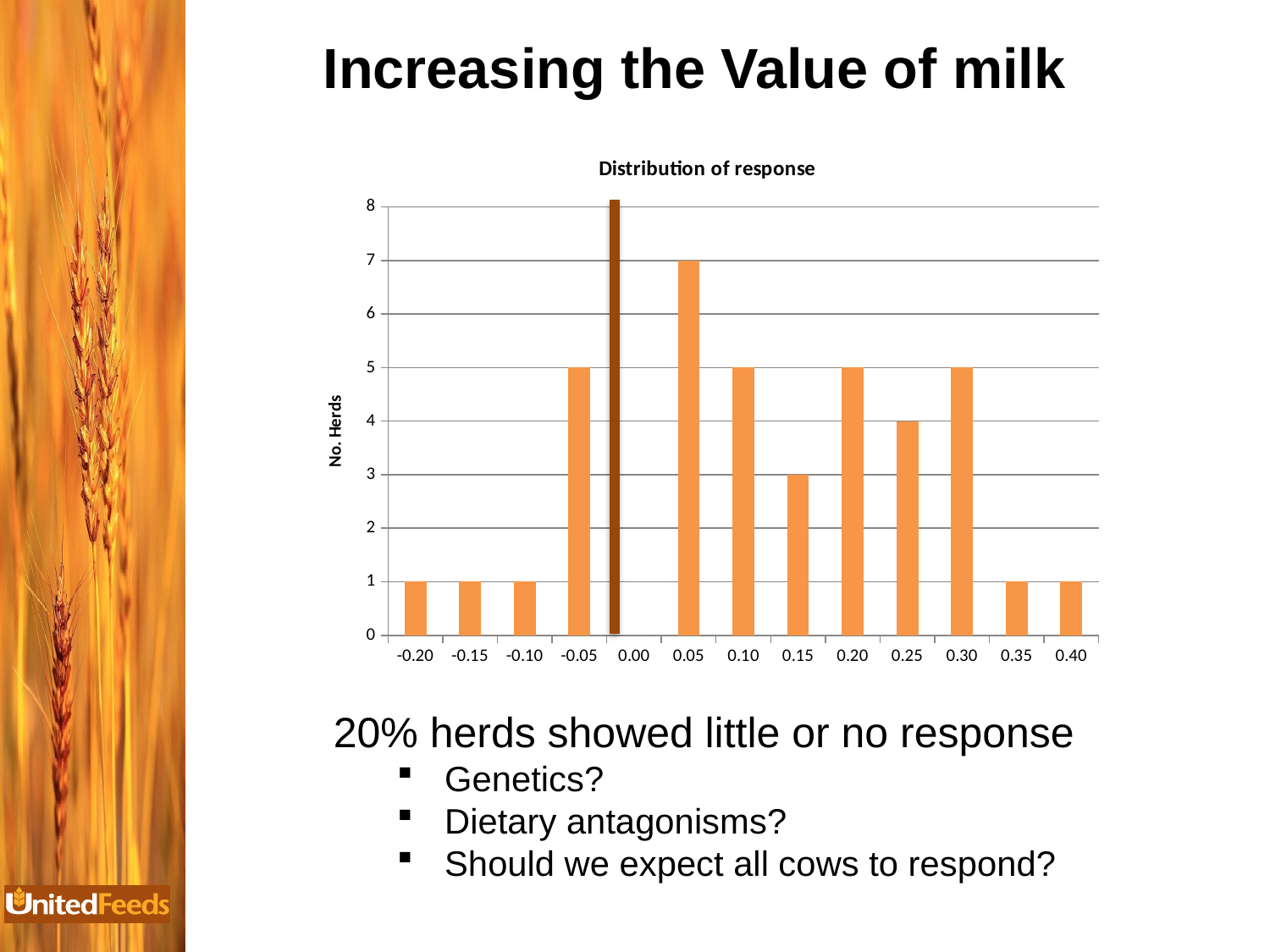
What is the title of the chart on the slide? Distribution of response In the Distribution of response chart, how many herds are shown for the -0.20 category? 1 In the Distribution of response chart, how many herds are shown for the 0.05 category? 7 In the Distribution of response chart, is the value for the 0.05 category greater or less than 6? greater In the Distribution of response chart, what is the number of herds for the 0.25 category? 4 In the Distribution of response chart, which category has more herds, 0.10 or 0.15? 0.10 In the Distribution of response chart, what is the number of herds for the 0.15 category? 3 In the Distribution of response chart, what is the difference in number of herds between the 0.05 and 0.15 categories? 4 What is the label on the vertical axis of the chart? No. Herds In the Distribution of response chart, what is the number of herds for the 0.30 category? 5 In the Distribution of response chart, which category has more herds, 0.25 or 0.30? 0.30 What kind of chart is shown on the slide? bar chart